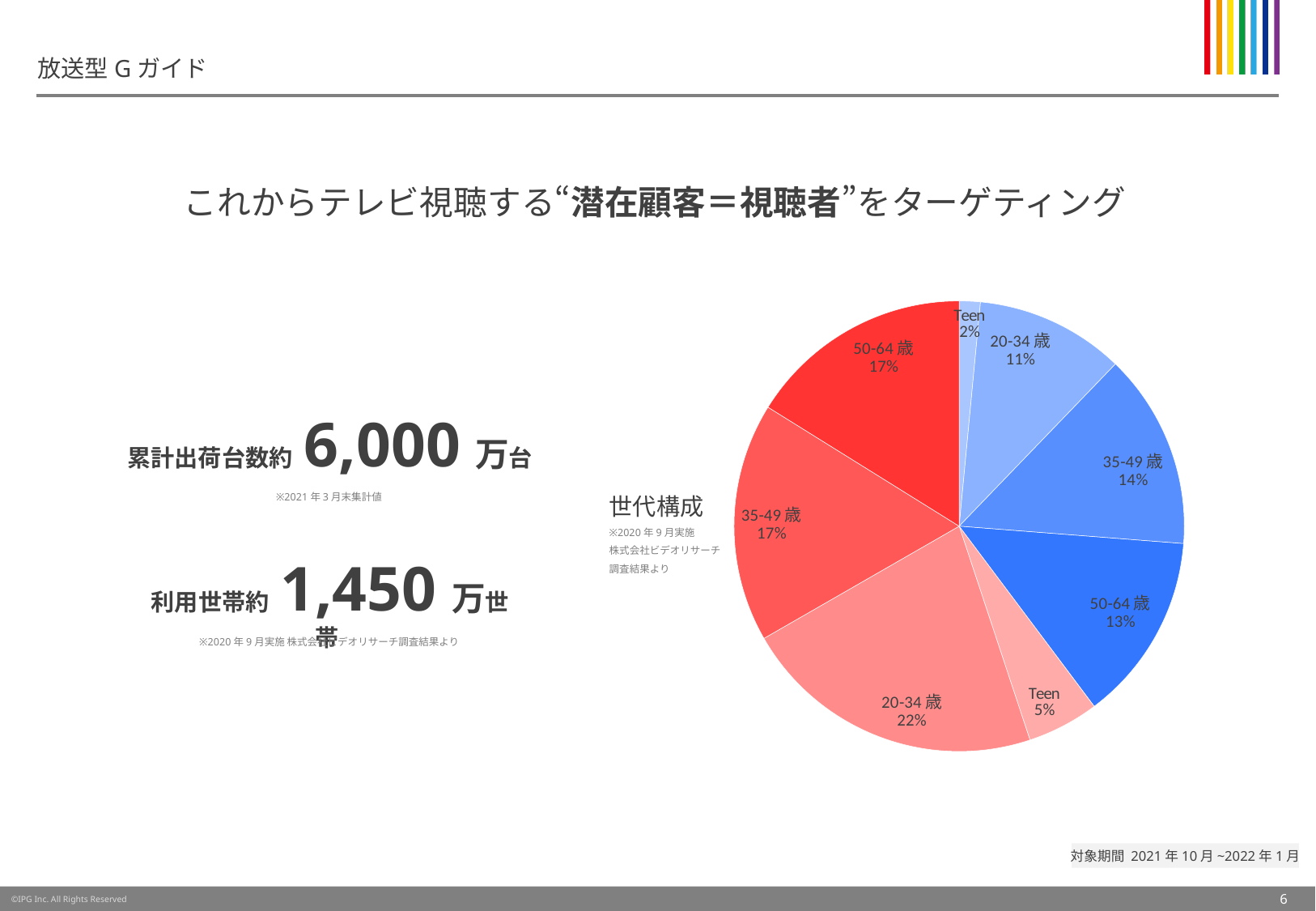
In the pie chart, what is the difference between the red 20-34歳 slice (22%) and the blue 20-34歳 slice (11%)? 11% In the pie chart, what is the share of the pink Teen slice? 5% In the pie chart, what share does the largest slice (20-34歳, red/pink) have? 22% In the pie chart, what is the share of the blue 50-64歳 slice? 13% What kind of chart is shown on the slide? pie chart What is the title of the pie chart? 世代構成 How many slices does the pie chart have? 8 In the pie chart, which is larger: the blue 20-34歳 slice or the red 20-34歳 slice? the red 20-34歳 slice In the pie chart, what is the share of the red 50-64歳 slice? 17% In the pie chart, what share does the smallest slice (Teen, blue) have? 2% In the pie chart, what is the combined share of the two Teen slices (2% and 5%)? 7% In the pie chart, what is the share of the blue 35-49歳 slice? 14%